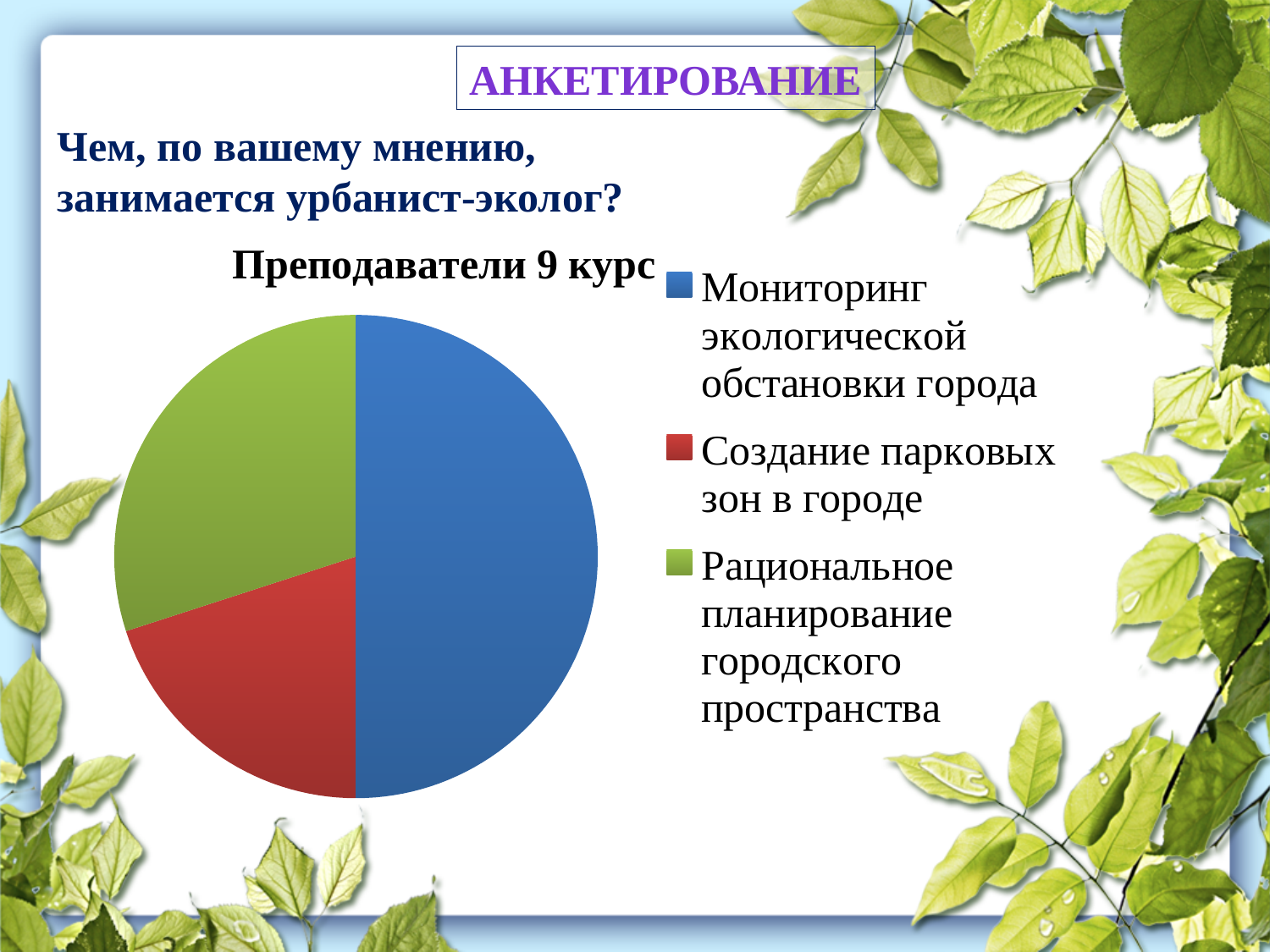
Which slice is larger: "Рациональное планирование городского пространства" or "Создание парковых зон в городе"? Рациональное планирование городского пространства How many slices does the pie chart have? 3 What colour is the slice for "Создание парковых зон в городе"? red Which category has the smallest slice of the pie chart? Создание парковых зон в городе What is the title of the pie chart? Преподаватели 9 курс Which category has the largest slice of the pie chart? Мониторинг экологической обстановки города How many entries does the legend of the pie chart list? 3 Which slice is larger: "Мониторинг экологической обстановки города" or "Рациональное планирование городского пространства"? Мониторинг экологической обстановки города What kind of chart is shown on the slide? pie chart